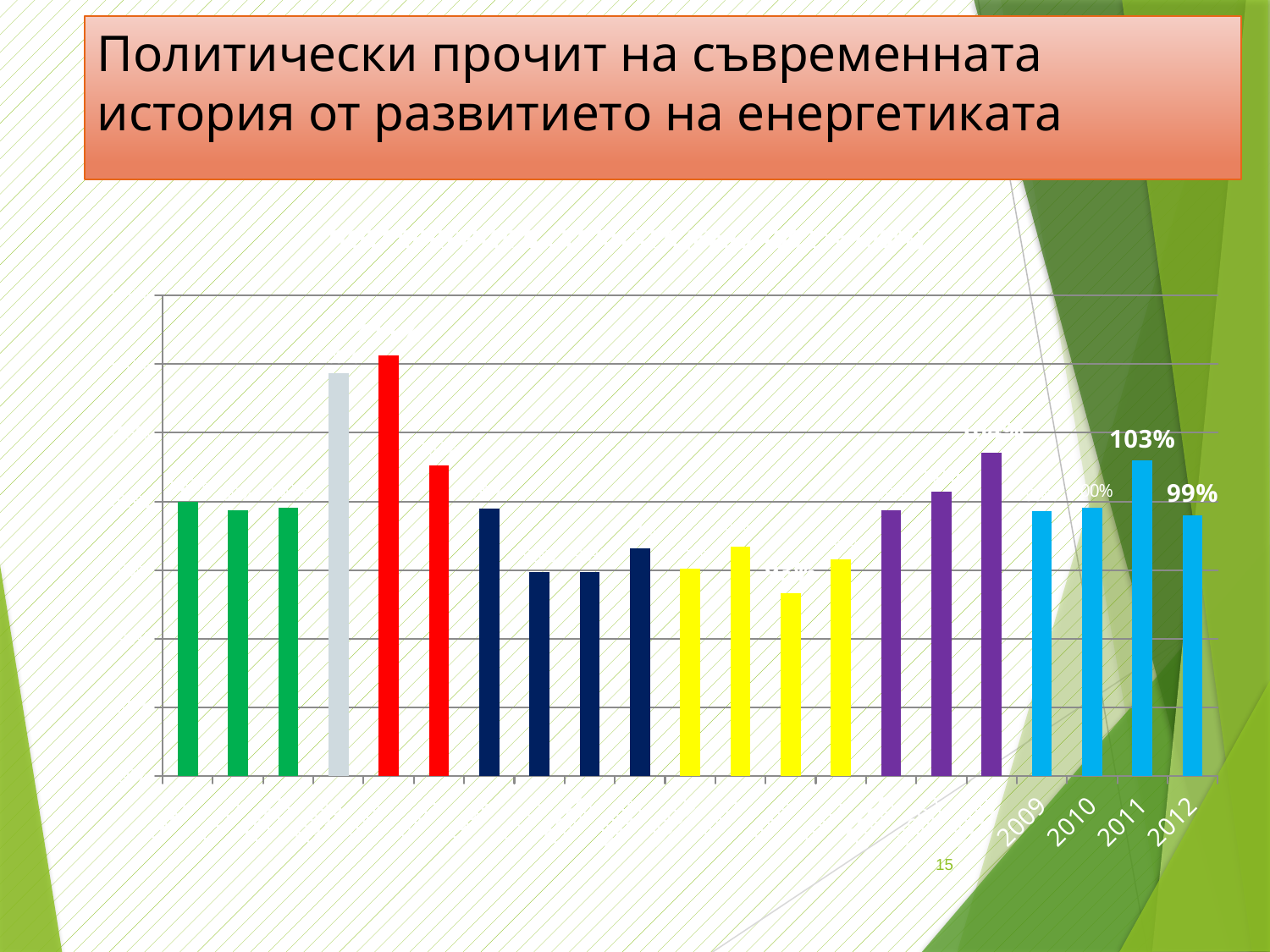
How many bars are plotted in the chart? 21 What kind of chart is shown on the slide? bar chart Which year has the larger value, 2010 or 2011? 2011 What is the value shown for 2011? 103% Which year has the larger value, 2011 or 2012? 2011 What colour is the tallest bar in the chart? red What is the value shown for 2012? 99% What colour are the bars for 2009 to 2012? light blue Among the years 2009 to 2012, which has the highest bar? 2011 What is the difference between the values for 2011 and 2012? 4% Do the values rise or fall from 2009 to 2011? rise Does the value rise or fall from 2011 to 2012? fall